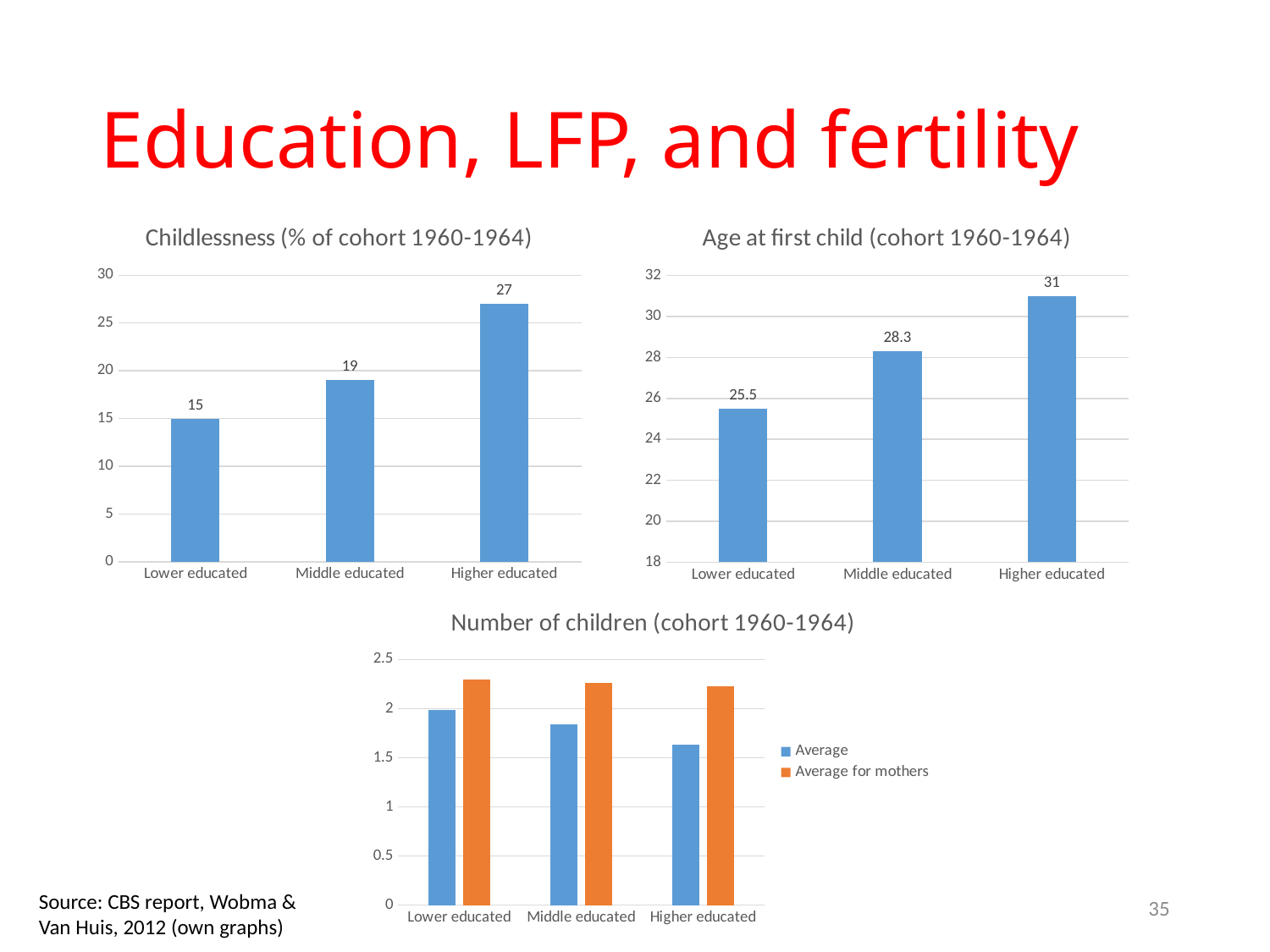
How many categories are shown on the x axis of the 'Number of children (cohort 1960-1964)' chart? 3 In the 'Age at first child (cohort 1960-1964)' chart, which category has the highest value? Higher educated In the 'Childlessness (% of cohort 1960-1964)' chart, what is the difference between Higher educated and Lower educated? 12 In the 'Number of children (cohort 1960-1964)' chart, is the Average value for Higher educated greater or less than 2? less In the 'Childlessness (% of cohort 1960-1964)' chart, which category has the lowest value? Lower educated What kind of chart is the 'Childlessness (% of cohort 1960-1964)' chart? bar chart In the 'Number of children (cohort 1960-1964)' chart, which is larger for Lower educated: Average or Average for mothers? Average for mothers In the 'Age at first child (cohort 1960-1964)' chart, do the values rise or fall from Lower educated to Higher educated? rise In the 'Age at first child (cohort 1960-1964)' chart, what is the value for Middle educated? 28.3 In the 'Age at first child (cohort 1960-1964)' chart, what is the difference between Higher educated and Lower educated? 5.5 In the 'Childlessness (% of cohort 1960-1964)' chart, what is the value for Higher educated? 27 In the 'Number of children (cohort 1960-1964)' chart, how many series does the legend list? 2